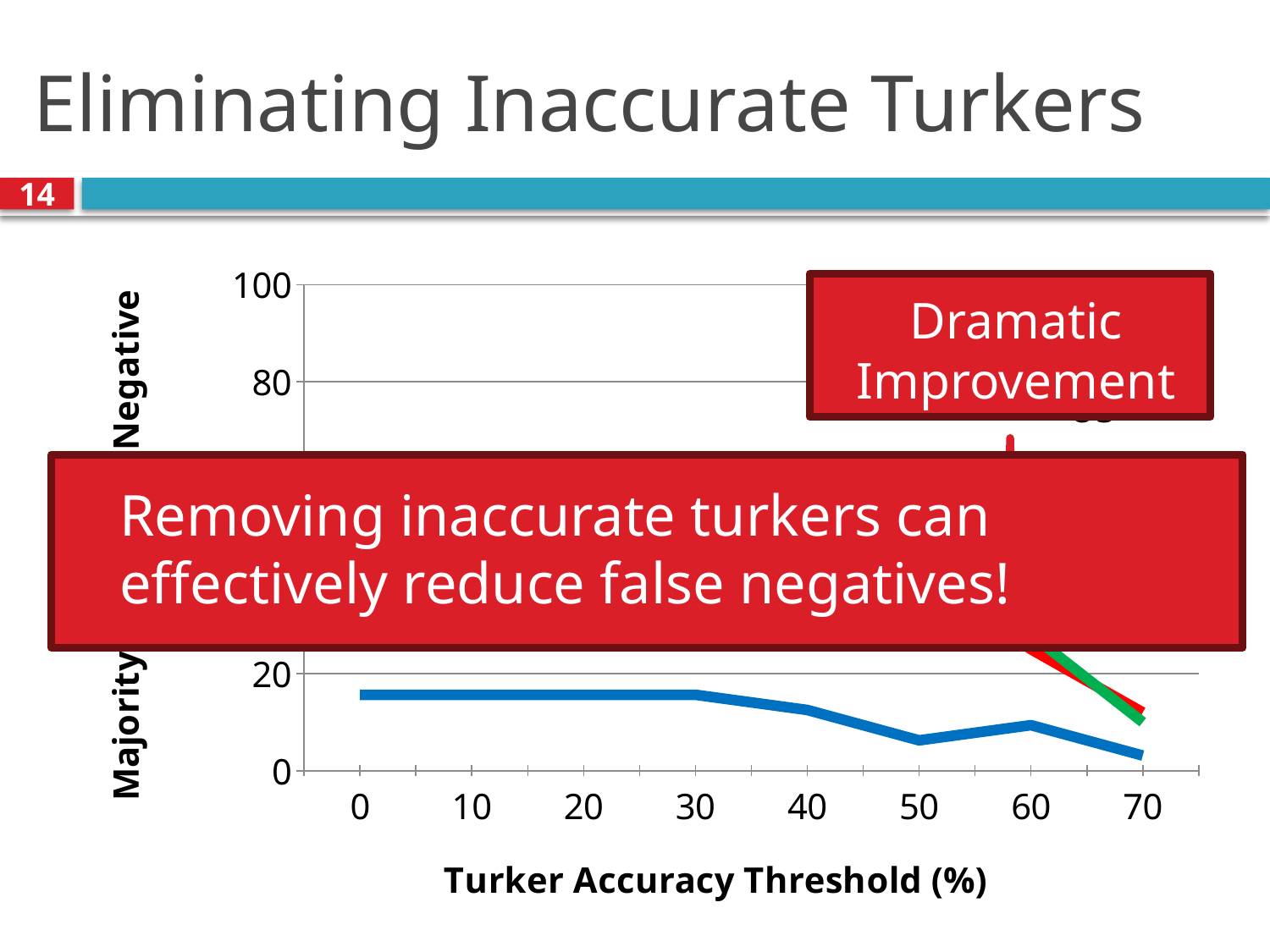
Does the blue line rise or fall as the Turker Accuracy Threshold increases from 0 to 70? fall How many tick labels are shown along the x axis of the chart? 8 What kind of chart is shown on the slide? line chart What is the title of the x axis of the chart? Turker Accuracy Threshold (%) At a Turker Accuracy Threshold of 70, which line has the higher value, the blue line or the red line? red line Is the value of the red line at a Turker Accuracy Threshold of 70 greater or less than 20? less Is the value of the green line at a Turker Accuracy Threshold of 70 greater or less than 20? less Is the value of the blue line at a Turker Accuracy Threshold of 70 greater or less than 20? less For the blue line, which Turker Accuracy Threshold has the higher value, 0 or 70? 0 How many coloured lines are plotted on the chart? 3 What is the highest value labelled on the y axis of the chart? 100